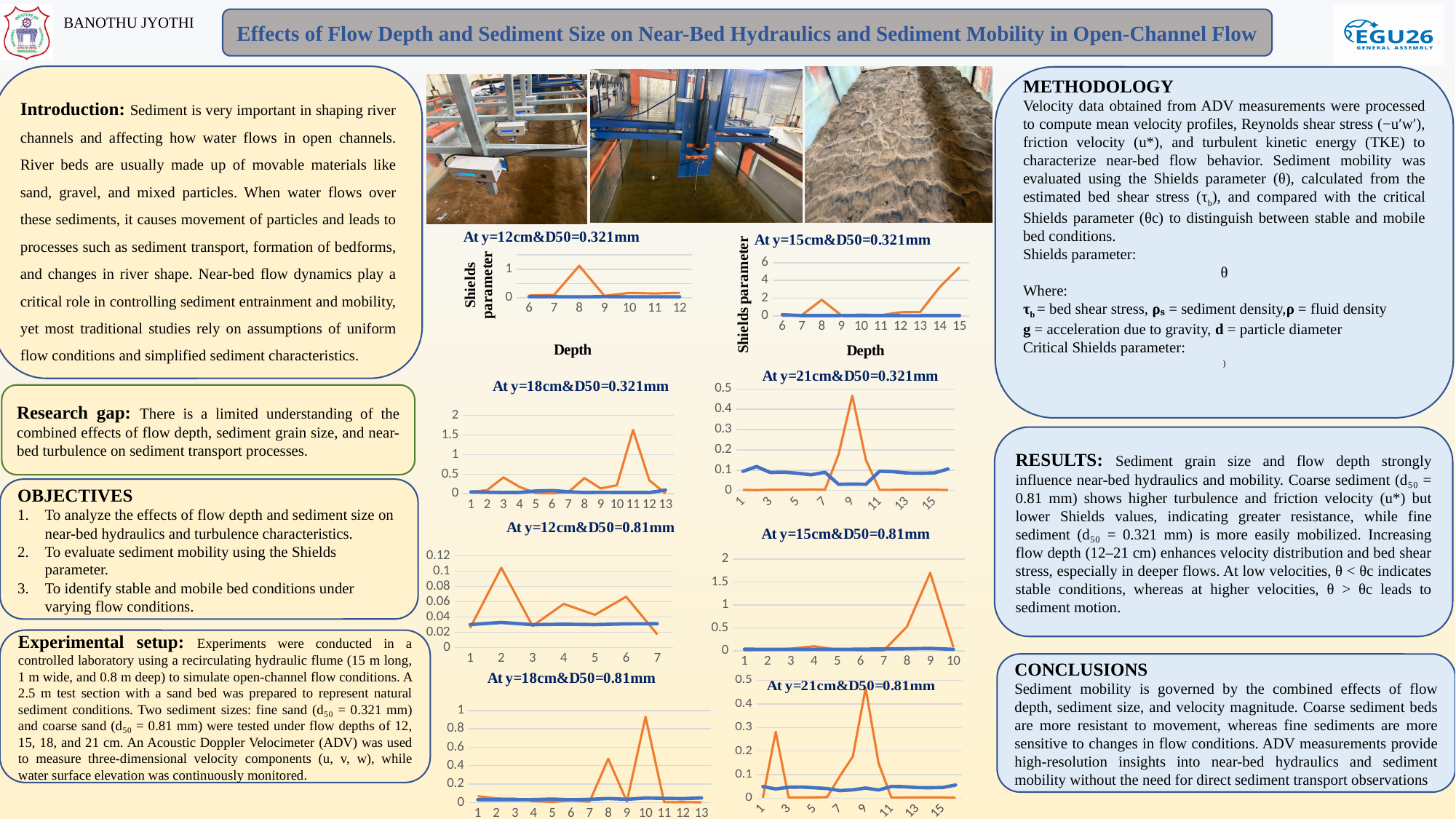
In the 'At y=15cm&D50=0.321mm' chart, is the orange line's value at x=15 greater or less than 4? greater In the 'At y=12cm&D50=0.321mm' chart, is the peak value of the orange line greater or less than 1? greater In the 'At y=12cm&D50=0.81mm' chart, at which x-axis value does the orange line reach its highest point? 2 What kind of chart is the 'At y=12cm&D50=0.321mm' chart? line chart In the 'At y=18cm&D50=0.321mm' chart, at which x-axis value does the orange line peak? 11 In the 'At y=18cm&D50=0.321mm' chart, is the orange line's peak value greater or less than 1.5? greater In the 'At y=15cm&D50=0.321mm' chart, at which x-axis value does the orange line reach its highest point? 15 What is the x-axis label of the 'At y=12cm&D50=0.321mm' chart? Depth